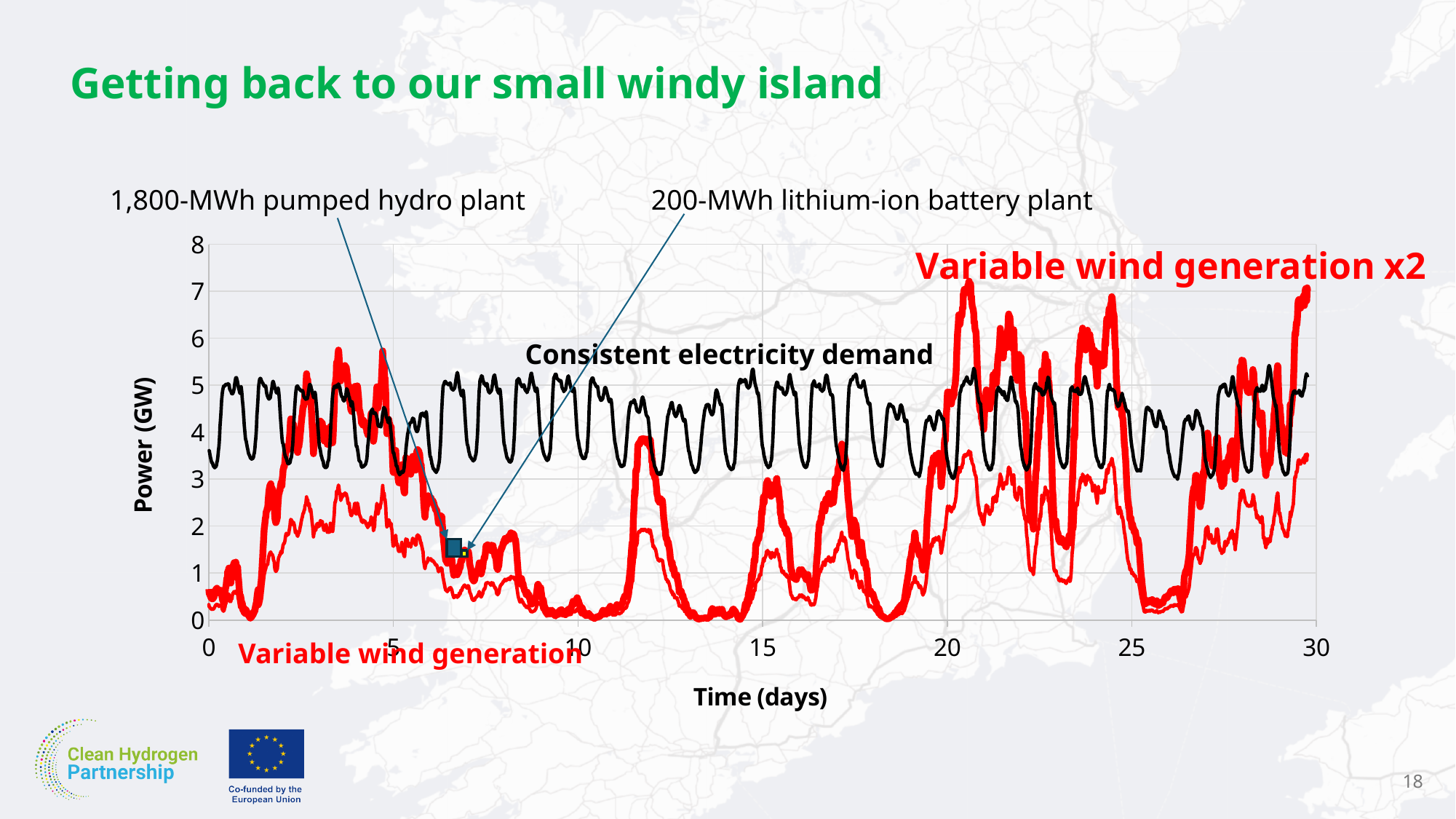
How many data series are plotted on the chart? 3 Is the peak value of the Variable wind generation series (not the x2 series) greater or less than 4 GW? less Which series reaches the highest value on the chart: Consistent electricity demand or Variable wind generation x2? Variable wind generation x2 What is the highest value shown on the x axis of the chart? 30 Around day 14, is the Variable wind generation value greater or less than 1 GW? less What is the highest value shown on the y axis of the chart? 8 What is the label of the y axis of the chart? Power (GW) What is the label of the x axis of the chart? Time (days) Is the peak value of the Variable wind generation x2 series greater or less than 6 GW? greater What kind of chart is shown on the slide? Line chart Which series has the lowest minimum value on the chart: Consistent electricity demand or Variable wind generation? Variable wind generation